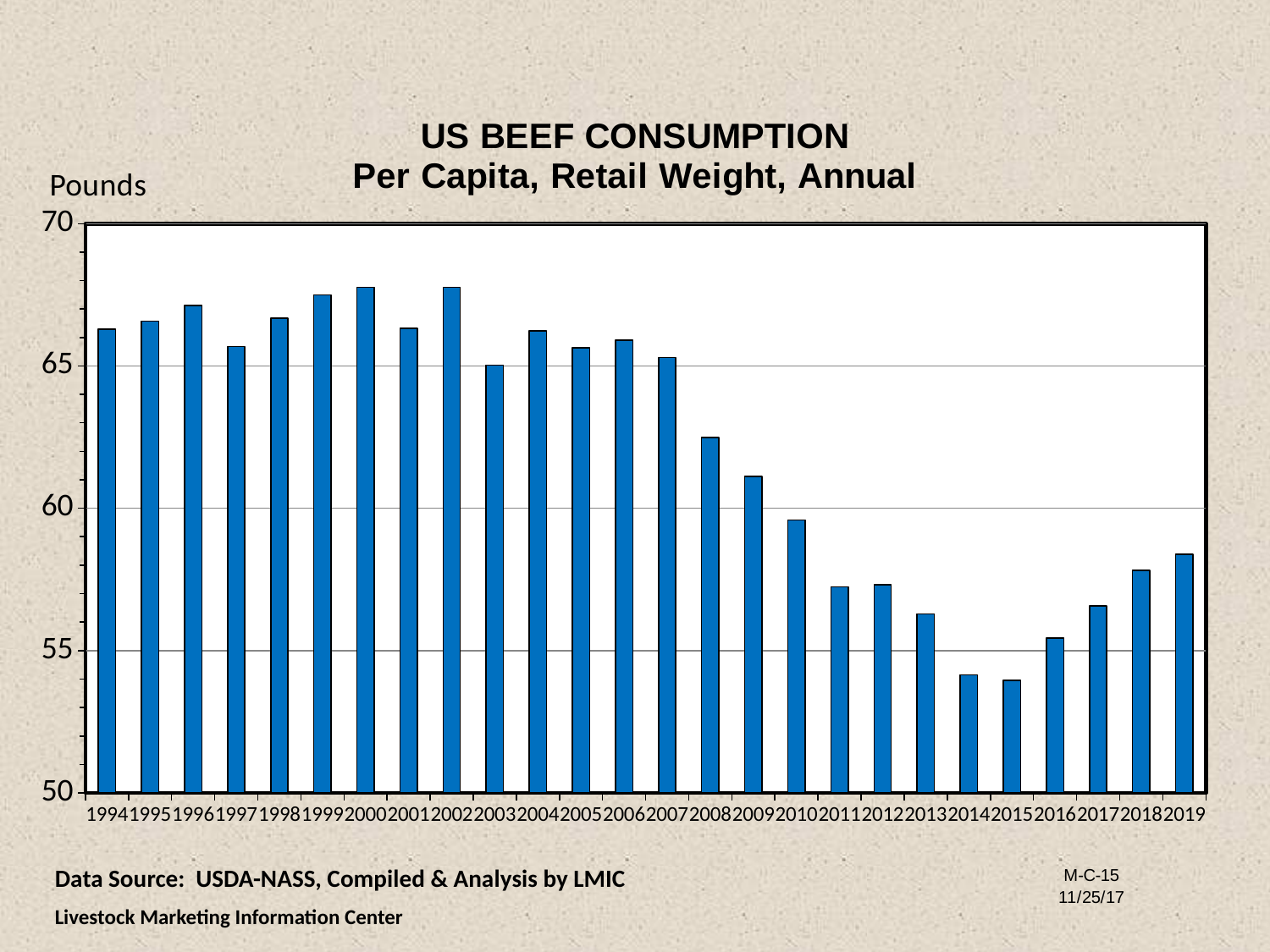
Which year has the larger value, 2014 or 2019? 2019 Is the value for 1999 greater or less than 65? greater Is the value for 2019 greater or less than 60? less Is the value for 2008 greater or less than 60? greater What is the title of the chart? US BEEF CONSUMPTION Per Capita, Retail Weight, Annual What kind of chart is shown on the slide? bar chart How many years are plotted on the x axis of the chart? 26 Do the values rise or fall from 2007 to 2015? fall What unit is shown on the y axis of the chart? Pounds Which year has the larger value, 2000 or 2015? 2000